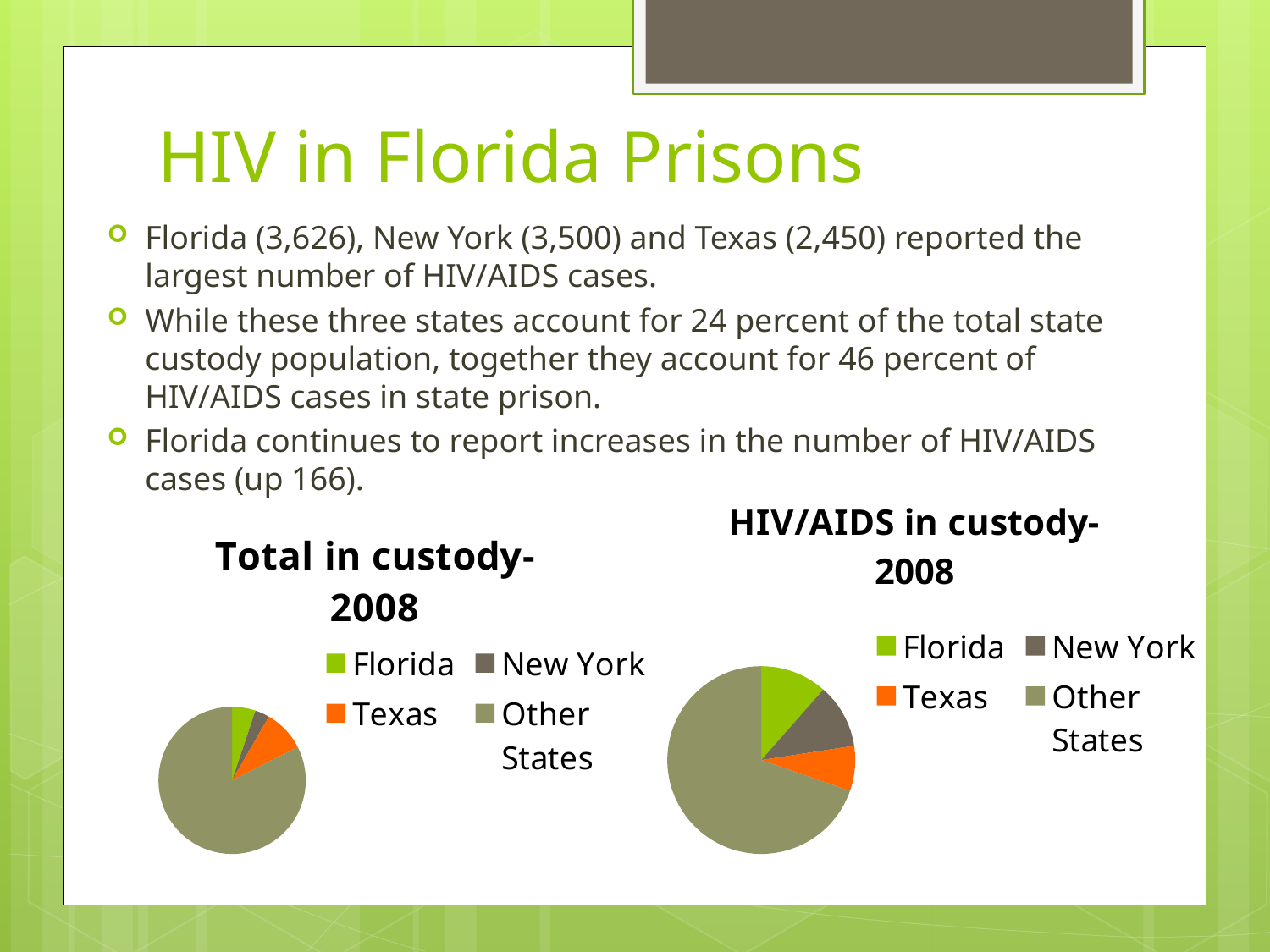
In the "Total in custody-2008" chart, which slice is larger, Texas or New York? Texas What kind of chart is the "Total in custody-2008" chart? pie chart How many pie charts are shown on the slide? 2 In the "Total in custody-2008" chart, which slice is larger, Other States or Texas? Other States In the "HIV/AIDS in custody-2008" chart, which category has the largest slice? Other States In the "HIV/AIDS in custody-2008" chart, how many categories does the legend list? 4 What kind of chart is the "HIV/AIDS in custody-2008" chart? pie chart In the "Total in custody-2008" chart, how many slices does the pie have? 4 In the "Total in custody-2008" chart, which category has the largest slice? Other States In the "HIV/AIDS in custody-2008" chart, which category is shown in orange? Texas What is the title of the pie chart on the right side of the slide? HIV/AIDS in custody-2008 In the "HIV/AIDS in custody-2008" chart, which slice is larger, Florida or Other States? Other States